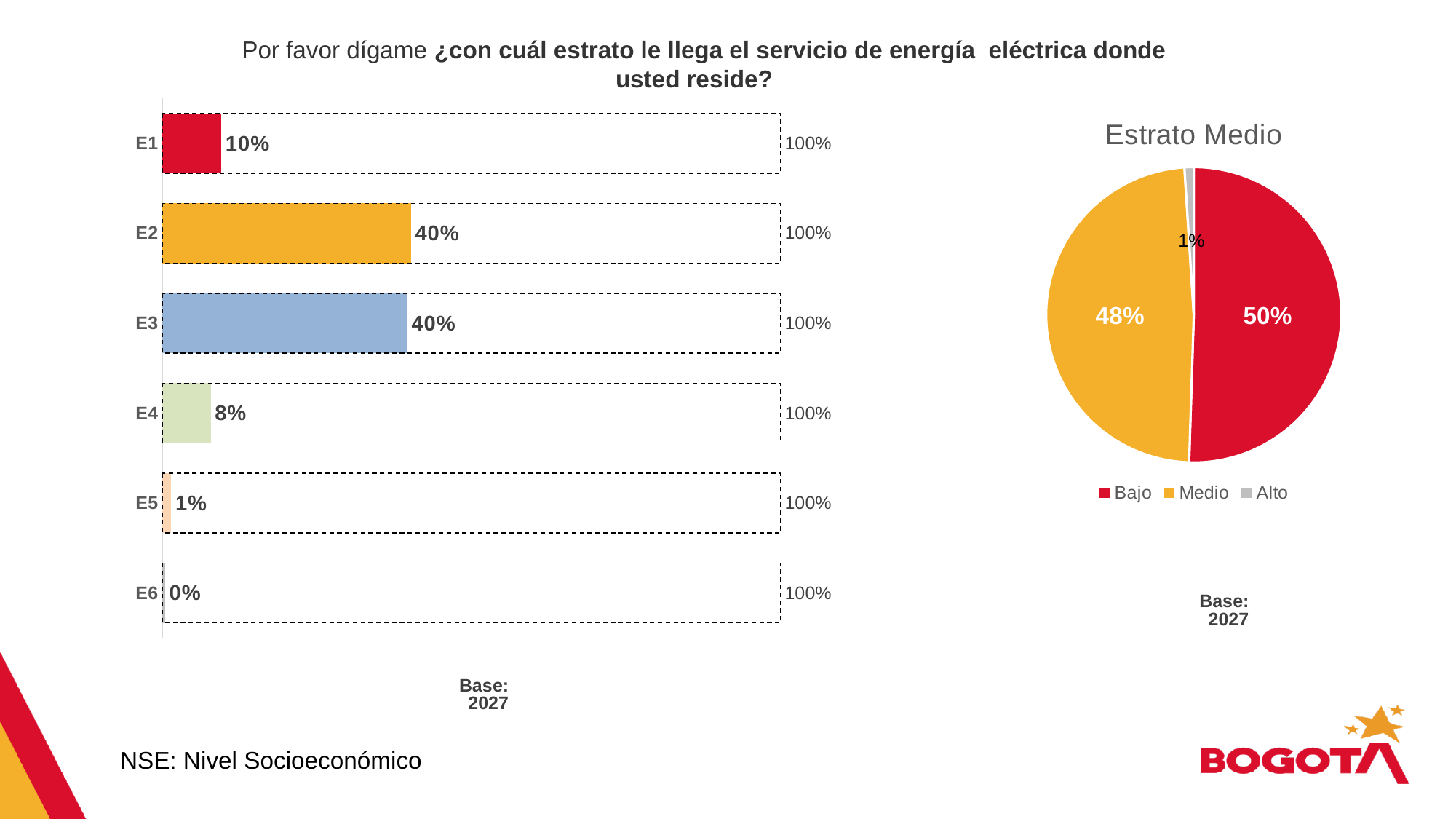
How many categories does the bar chart on the left show? 6 In the bar chart on the left, which is larger, the value for E1 or the value for E4? E1 In the 'Estrato Medio' pie chart, which slice is the smallest? Alto In the 'Estrato Medio' pie chart, what share does Medio have? 48% In the bar chart on the left, what is the value for E5? 1% In the bar chart on the left, which category has the lowest value? E6 In the 'Estrato Medio' pie chart, what share does Bajo have? 50% What kind of chart is the chart on the left? bar chart In the bar chart on the left, what is the difference between the values for E1 and E4? 2% In the bar chart on the left, what is the value for E4? 8% How many entries does the legend of the 'Estrato Medio' pie chart list? 3 In the bar chart on the left, what is the value for E1? 10%